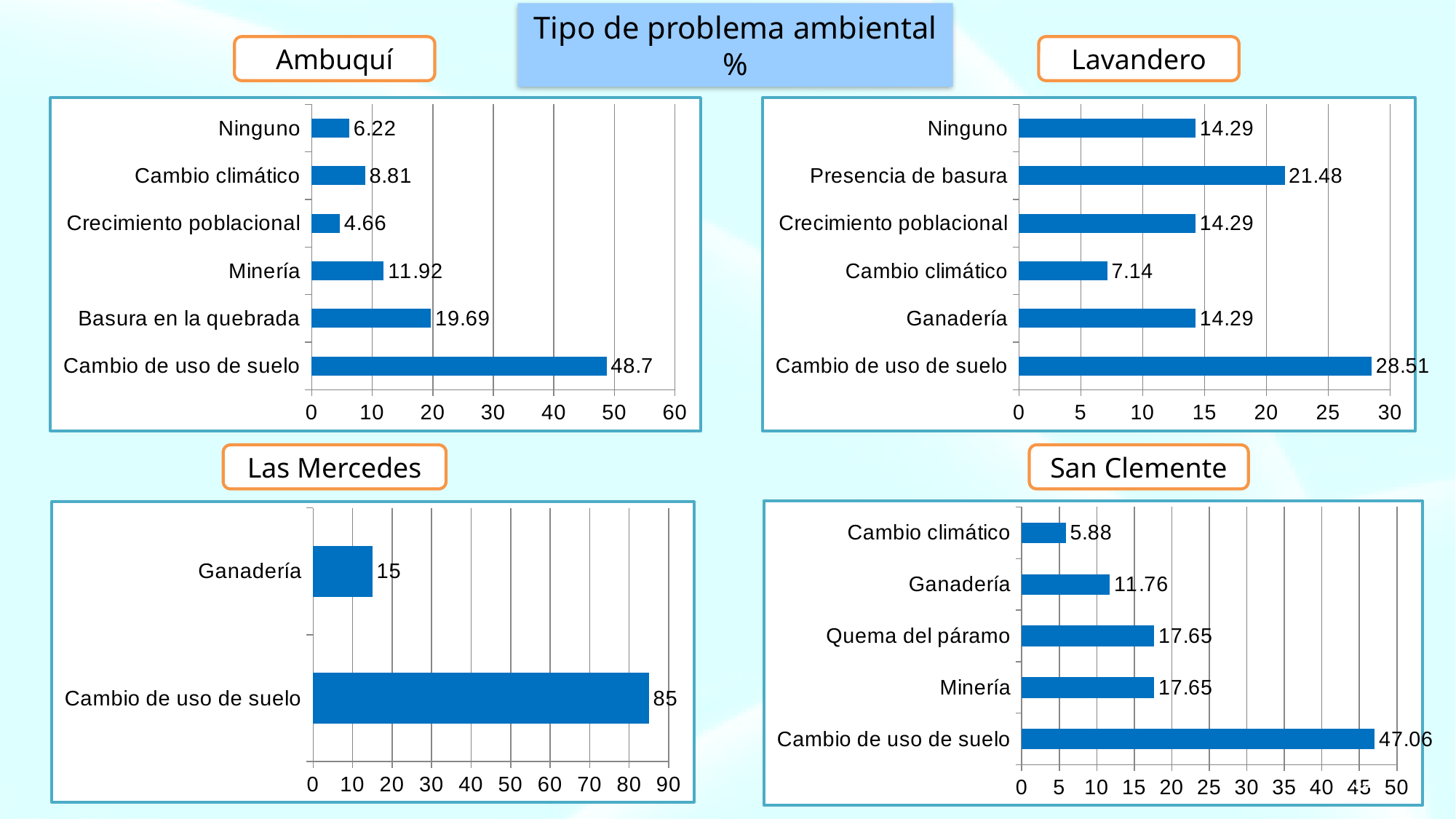
In the Lavandero chart, how many categories are shown? 6 In the Lavandero chart, what is the value for Presencia de basura? 21.48 In the Lavandero chart, what is the difference between Cambio de uso de suelo and Cambio climático? 21.37 In the Ambuquí chart, which category has the lowest value? Crecimiento poblacional In the Ambuquí chart, what is the value for Minería? 11.92 In the Ambuquí chart, which category has the highest value? Cambio de uso de suelo What kind of chart is the San Clemente chart? Bar chart In the San Clemente chart, which is larger, Quema del páramo or Cambio climático? Quema del páramo In the San Clemente chart, what is the value for Ganadería? 11.76 In the Las Mercedes chart, what is the difference between Cambio de uso de suelo and Ganadería? 70 How many charts are shown on the slide? 4 In the Las Mercedes chart, what is the value for Cambio de uso de suelo? 85